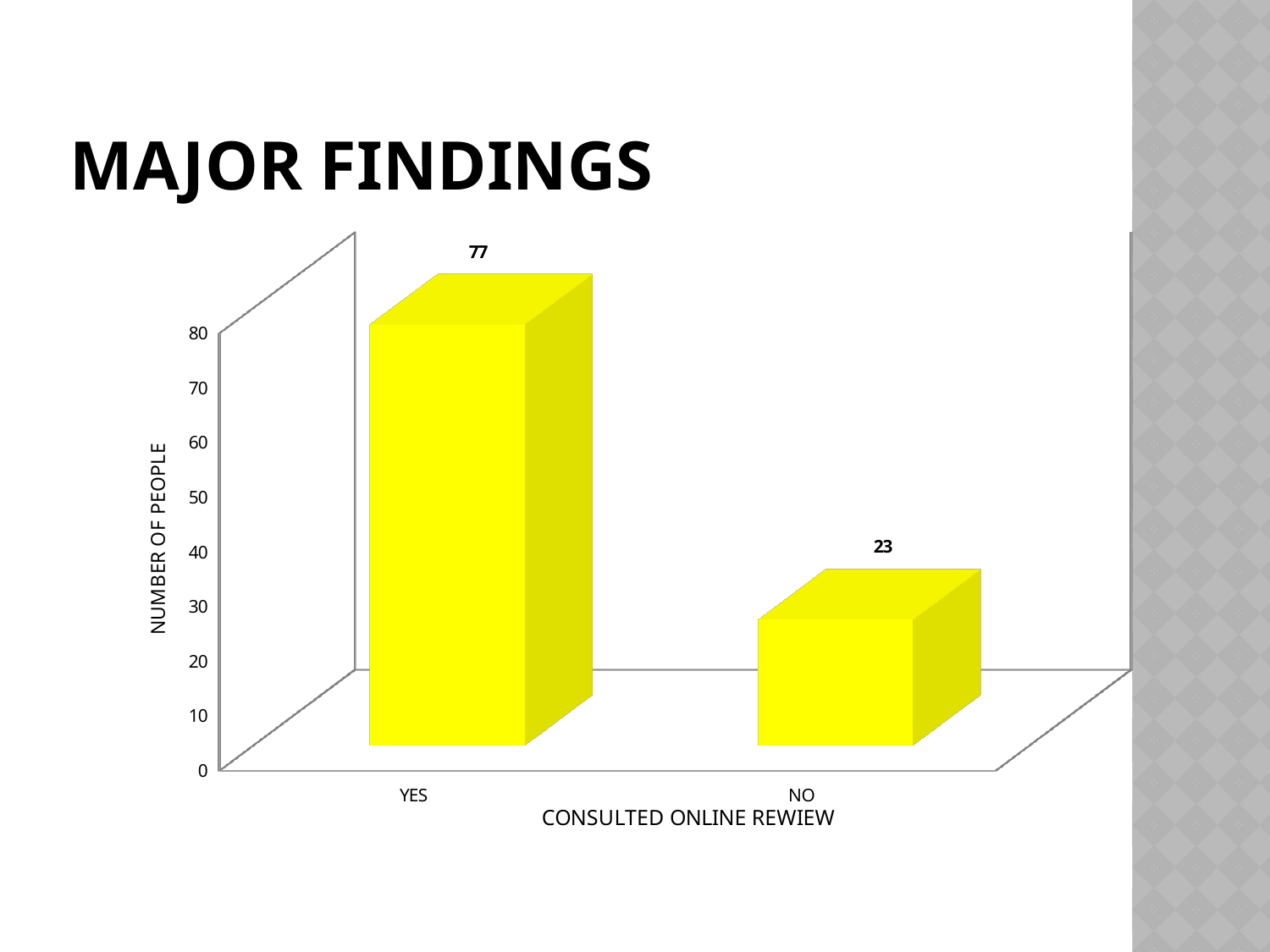
Is the value for YES greater or less than 70? greater Which category has the highest value? YES What is the label of the horizontal axis? CONSULTED ONLINE REWIEW What is the difference between the values for YES and NO? 54 What is the value for YES? 77 How many categories are shown on the x axis? 2 Which is larger, the value for YES or the value for NO? YES What kind of chart is shown on the slide? bar chart Is the value for NO greater or less than 30? less Which category has the lowest value? NO What is the label of the vertical axis? NUMBER OF PEOPLE What is the value for NO? 23